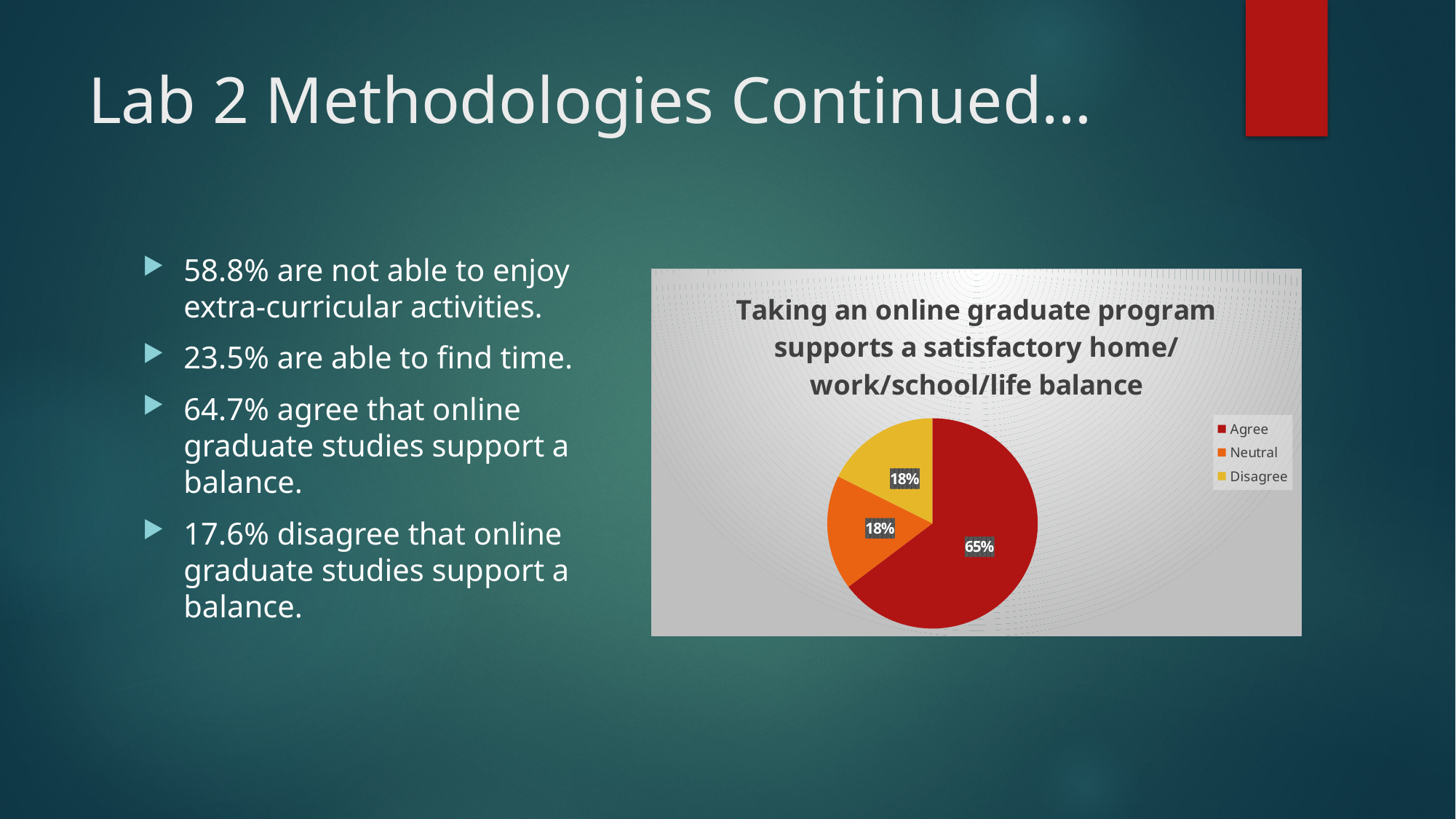
What is the difference between the Agree share and the Neutral share? 47% How many categories does the pie chart show? 3 What share of the pie is labelled Agree? 65% What share of the pie is labelled Disagree? 18% What kind of chart is shown on the slide? Pie chart Which colour represents Disagree in the pie chart? Yellow Which is larger, the Agree slice or the Disagree slice? Agree What is the title of the chart? Taking an online graduate program supports a satisfactory home/ work/school/life balance Which category has the largest slice of the pie? Agree Is the Agree share greater or less than 50%? greater What share of the pie is labelled Neutral? 18%